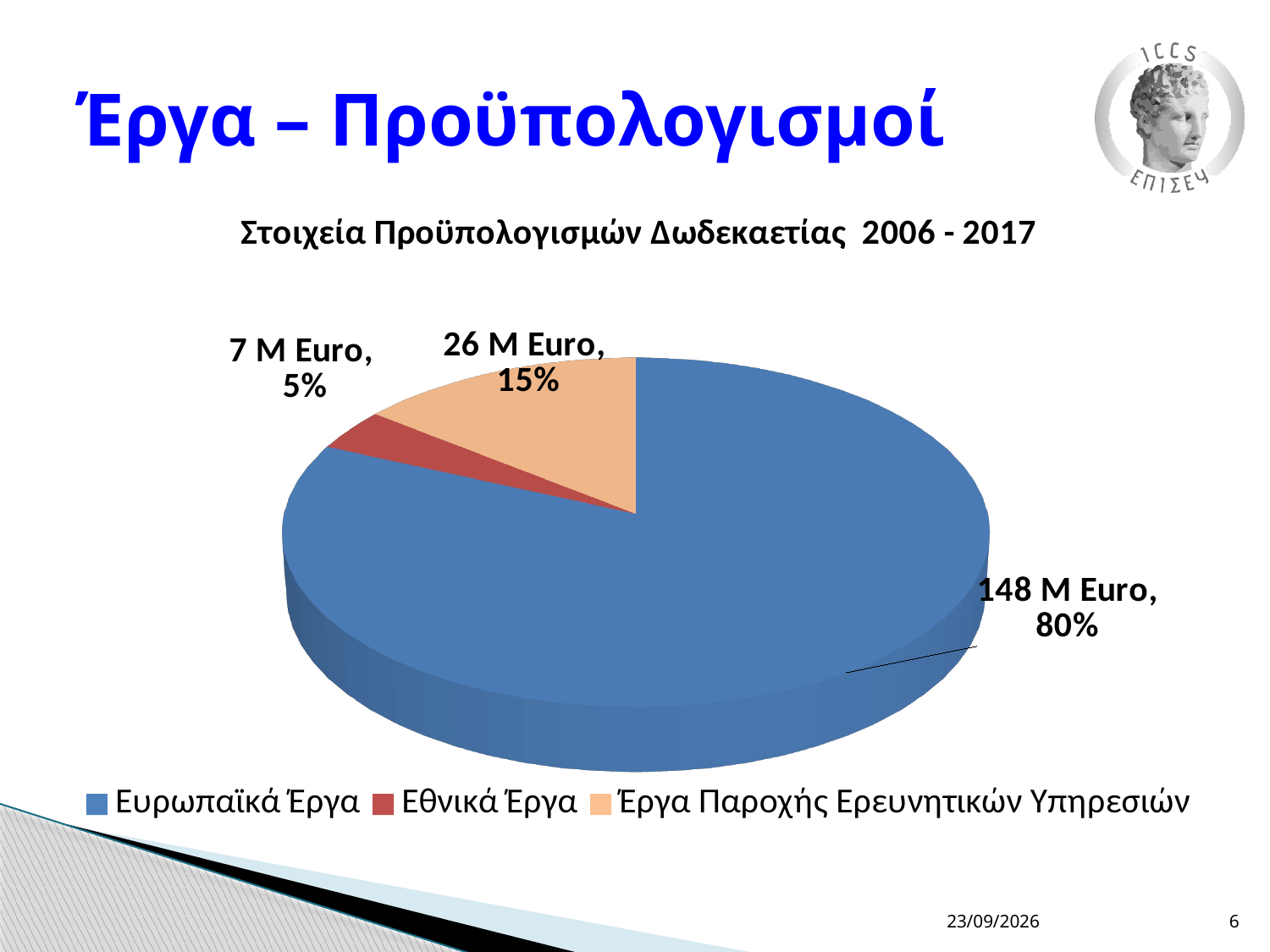
What is the value for Ευρωπαϊκά Έργα? 148 M Euro What share of the pie does Ευρωπαϊκά Έργα represent? 80% What kind of chart is shown on the slide? Pie chart How many categories does the pie chart show? 3 Which category has the largest slice? Ευρωπαϊκά Έργα What is the difference in M Euro between Ευρωπαϊκά Έργα and Έργα Παροχής Ερευνητικών Υπηρεσιών? 122 M Euro What share of the pie does Έργα Παροχής Ερευνητικών Υπηρεσιών represent? 15% What is the value for Έργα Παροχής Ερευνητικών Υπηρεσιών? 26 M Euro Which category has the smallest slice? Εθνικά Έργα What share of the pie does Εθνικά Έργα represent? 5% What is the title of the chart? Στοιχεία Προϋπολογισμών Δωδεκαετίας 2006 - 2017 What is the value for Εθνικά Έργα? 7 M Euro